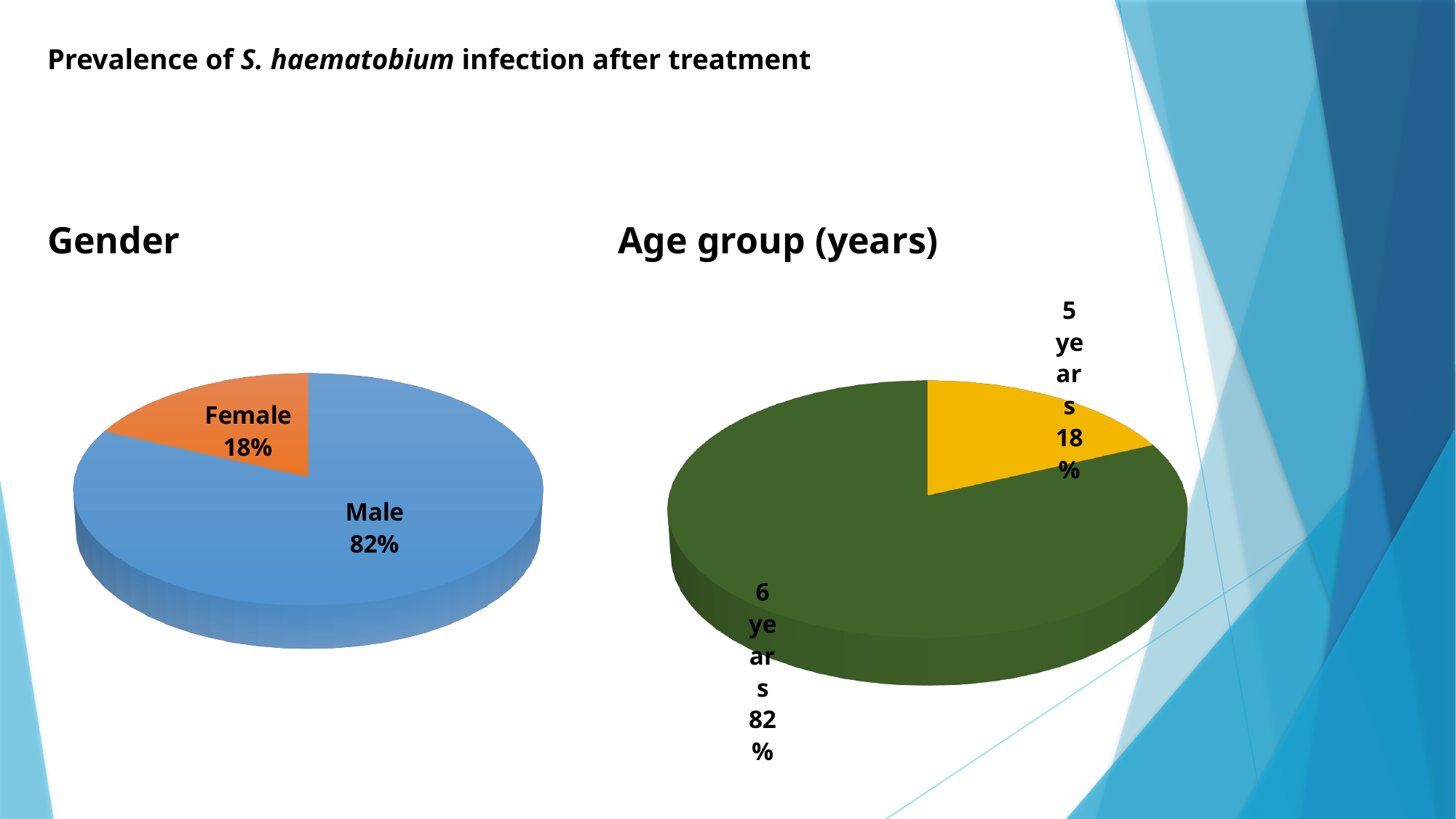
In the Gender chart, what percentage is shown for Male? 82% In the Age group (years) chart, what colour is the 6 years slice? Green In the Age group (years) chart, which category has the smallest share? 5 years In the Gender chart, which category has the largest share? Male In the Gender chart, what percentage is shown for Female? 18% In the Age group (years) chart, what percentage is shown for 5 years? 18% In the Age group (years) chart, which is larger, the share for 5 years or for 6 years? 6 years How many slices does the Age group (years) chart have? 2 What kind of chart is the Gender chart? Pie chart In the Age group (years) chart, what percentage is shown for 6 years? 82% In the Gender chart, what is the difference in percentage points between Male and Female? 64 How many slices does the Gender chart have? 2